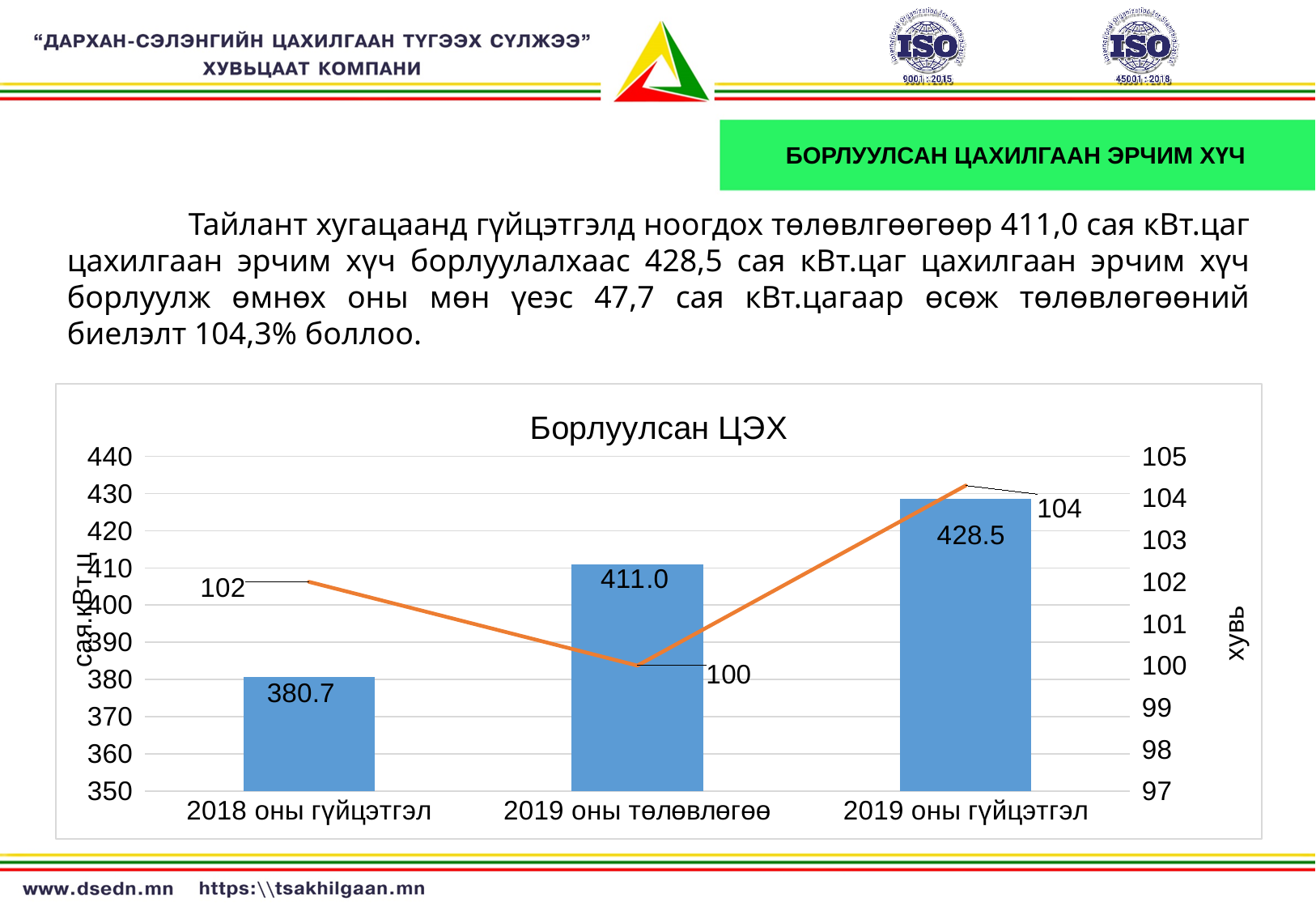
What is the bar value for 2019 оны гүйцэтгэл? 428.5 What is the line value (percent) for 2019 оны төлөвлөгөө? 100 What is the bar value for 2018 оны гүйцэтгэл? 380.7 How many categories are shown on the x axis? 3 Which category has the highest bar value? 2019 оны гүйцэтгэл What is the title of the chart? Борлуулсан ЦЭХ What is the line value (percent) for 2019 оны гүйцэтгэл? 104 What is the bar value for 2019 оны төлөвлөгөө? 411.0 Which category has the lowest bar value? 2018 оны гүйцэтгэл What is the difference between the bar values for 2019 оны гүйцэтгэл and 2019 оны төлөвлөгөө? 17.5 Which is larger, the bar value for 2019 оны төлөвлөгөө or for 2018 оны гүйцэтгэл? 2019 оны төлөвлөгөө Do the bar values rise or fall from left to right along the x axis? rise